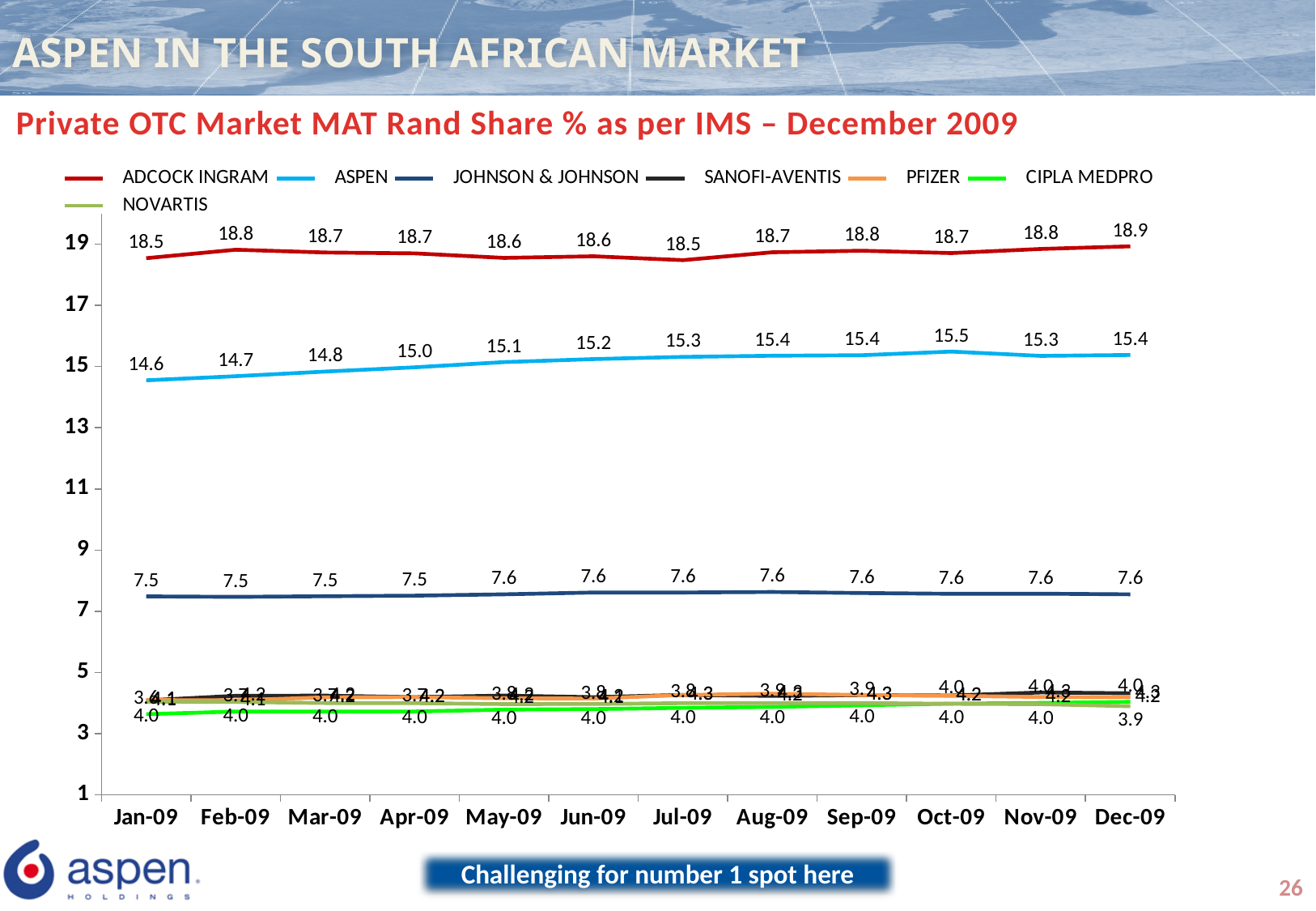
Which is larger in Jul-09, ADCOCK INGRAM or ASPEN? ADCOCK INGRAM Does the ASPEN series rise or fall from Jan-09 to Dec-09? rise What is the difference between ADCOCK INGRAM and ASPEN in Dec-09? 3.5 What is the value for ASPEN in Jan-09? 14.6 What is the value for CIPLA MEDPRO in Dec-09? 4.0 How many series does the legend list? 7 In which month does ASPEN reach its highest value? Oct-09 What kind of chart is shown on the slide? line chart What is the value for JOHNSON & JOHNSON in Jan-09? 7.5 What is the value for ADCOCK INGRAM in Dec-09? 18.9 How many months are plotted on the x axis? 12 Is the value for ASPEN in Jun-09 greater or less than 15? greater